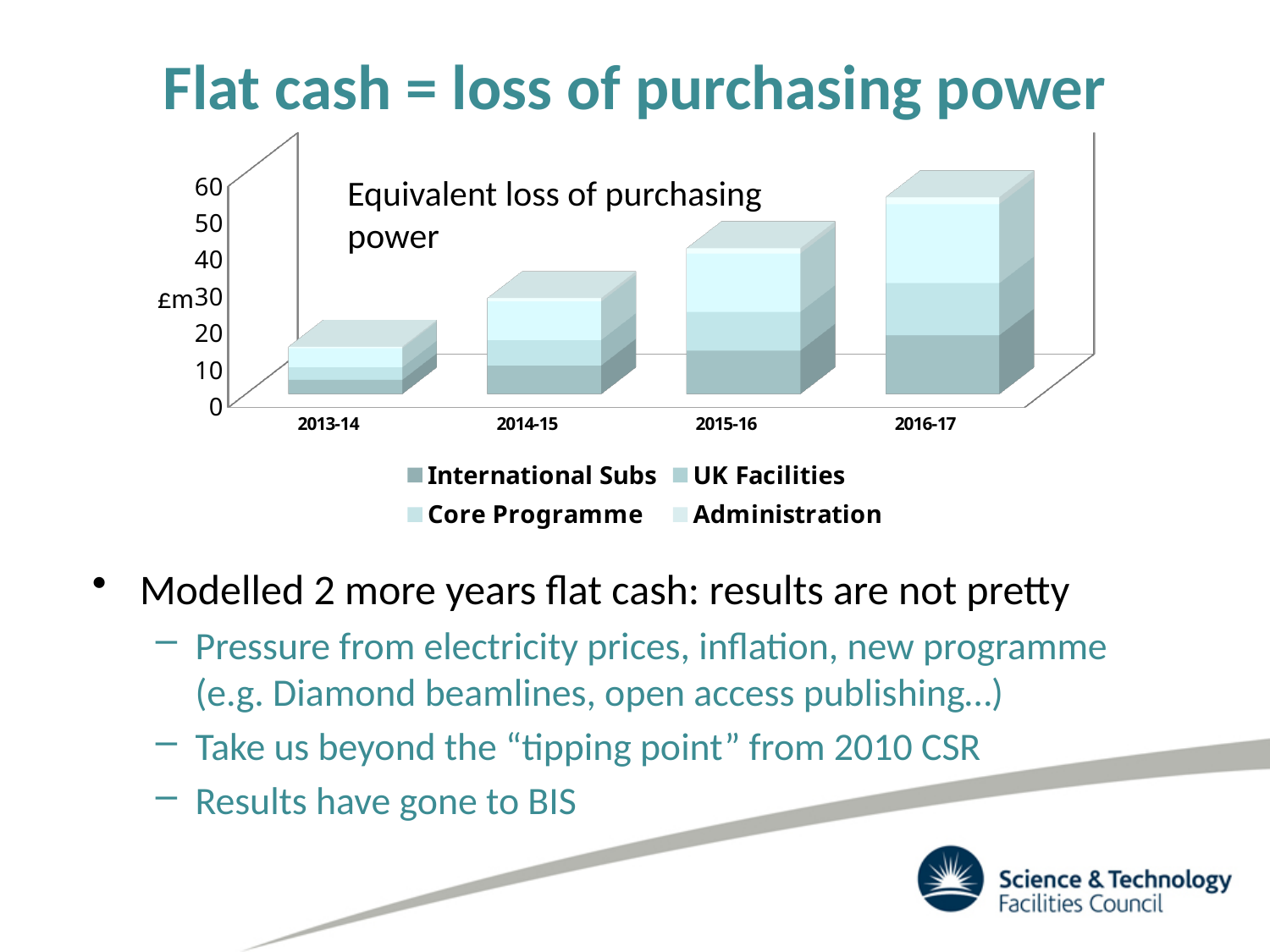
Is the total value for 2016-17 greater or less than 40? greater What is the title shown inside the chart area? Equivalent loss of purchasing power Is the total value for 2015-16 greater or less than 20? greater Which year has the shortest stacked bar in the chart? 2013-14 How many series does the chart legend list? 4 What unit is shown on the chart's vertical axis? £m Do the stacked bar totals rise or fall from 2013-14 to 2016-17? Rise Which year has the tallest stacked bar in the chart? 2016-17 Is the total value for 2013-14 greater or less than 30? less Which is larger, the total bar for 2016-17 or the total bar for 2013-14? 2016-17 How many years are shown on the x axis of the chart? 4 What kind of chart is shown on the slide? Stacked bar chart